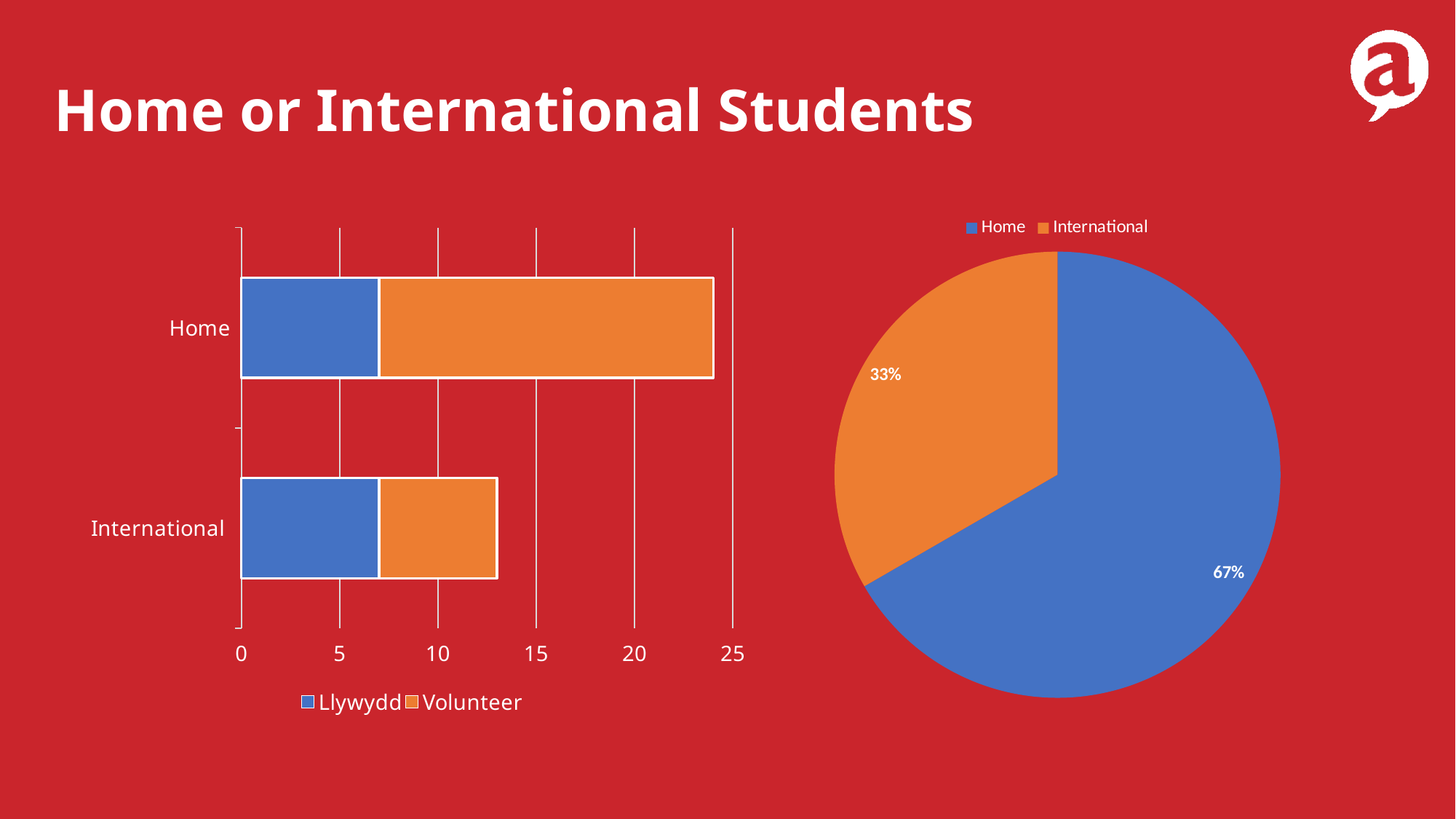
In the bar chart on the left, is the total length of the International bar greater or less than 15? less In the bar chart on the left, which category has the longer total bar, Home or International? Home How many slices does the pie chart on the right have? 2 In the pie chart on the right, which slice is the largest? Home In the pie chart on the right, what share does Home have? 67% What kind of chart is the chart on the left of the slide? bar chart In the bar chart on the left, which category has the larger Volunteer segment, Home or International? Home In the bar chart on the left, is the total length of the Home bar greater or less than 20? greater How many series does the legend of the bar chart on the left list? 2 What are the two series named in the legend of the bar chart on the left? Llywydd and Volunteer What kind of chart is the chart on the right of the slide? pie chart In the pie chart on the right, what share does International have? 33%